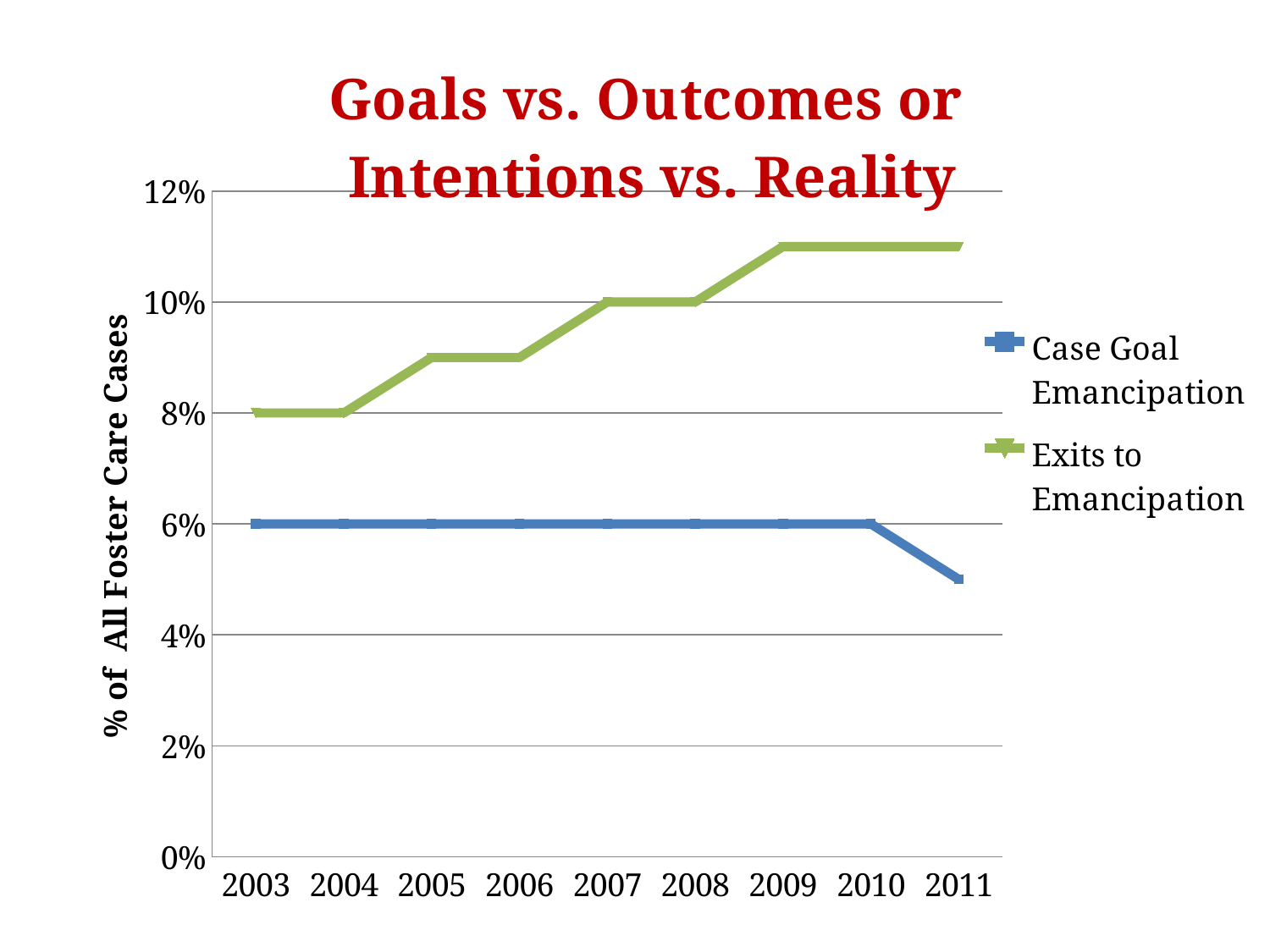
What is the value for Exits to Emancipation in 2007? 10% What is the title of the y axis? % of All Foster Care Cases Which series has the higher value in 2009, Case Goal Emancipation or Exits to Emancipation? Exits to Emancipation What is the difference between Exits to Emancipation and Case Goal Emancipation in 2008? 4% Does the Exits to Emancipation line rise or fall from 2003 to 2011? rise How many series does the legend list? 2 What is the value for Exits to Emancipation in 2003? 8% How many years are shown on the x axis? 9 Is the value for Case Goal Emancipation in 2011 greater or less than 6%? less Is the value for Exits to Emancipation in 2011 greater or less than 10%? greater What type of chart is shown on the slide? line chart What is the value for Case Goal Emancipation in 2005? 6%